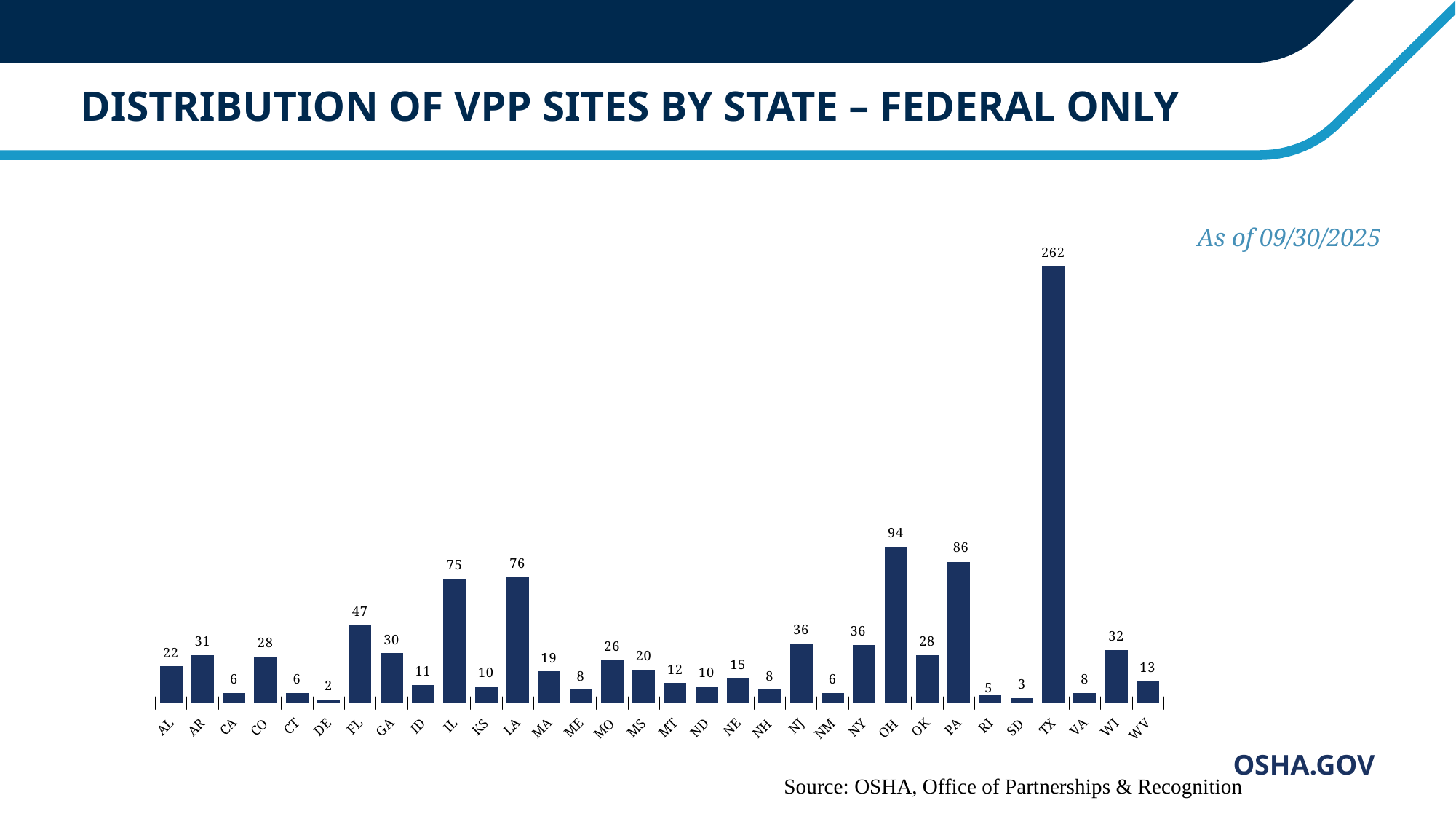
Which state has the highest number of VPP sites? TX Which has a larger value, FL or GA? FL What is the value shown for OH? 94 How many VPP sites does Texas (TX) have? 262 What is the value shown for FL? 47 What date is the data on the chart current as of? 09/30/2025 What kind of chart is shown on the slide? Bar chart What is the difference between the values for OH and PA? 8 What is the difference between the values for TX and OH? 168 Which has a larger value, IL or LA? LA How many states are shown on the x axis? 32 Which state has the lowest number of VPP sites? DE